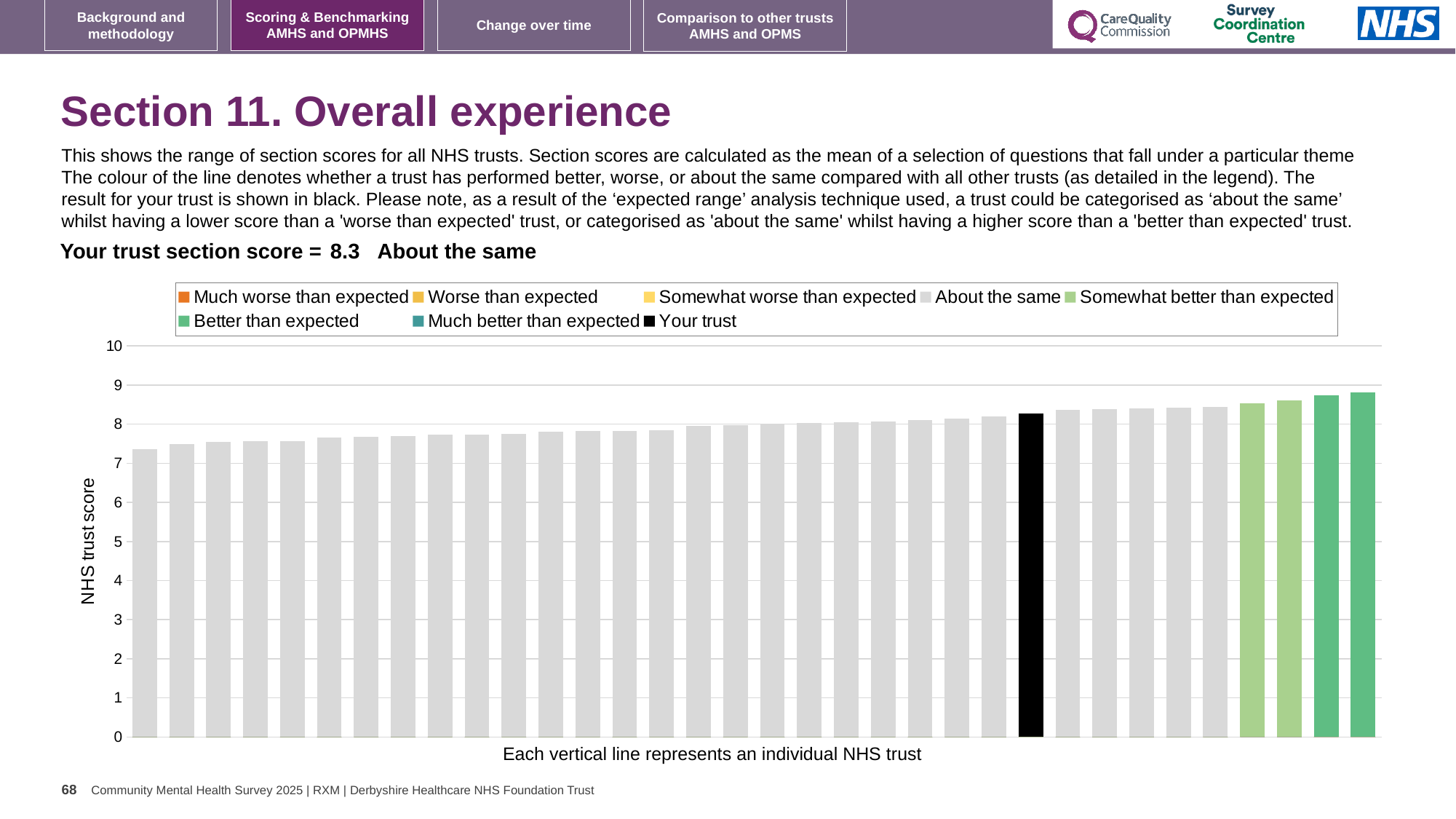
Is the value of the black 'Your trust' bar greater or less than 8? greater How many bars in the chart are coloured green (better than expected categories)? 4 Is the value of the rightmost bar greater or less than 9? less Which bar has the highest value: the leftmost bar or the rightmost bar? the rightmost bar What kind of chart is shown on the slide? bar chart Is the value of the leftmost bar greater or less than 7? greater Do the bar values rise or fall from left to right along the x axis? rise What colour is the bar representing your trust? black What category does the 'Your trust' score of 8.3 fall into according to the slide? About the same How many entries does the chart legend list? 8 What is the section score for your trust shown on the slide? 8.3 What is the label on the vertical axis? NHS trust score